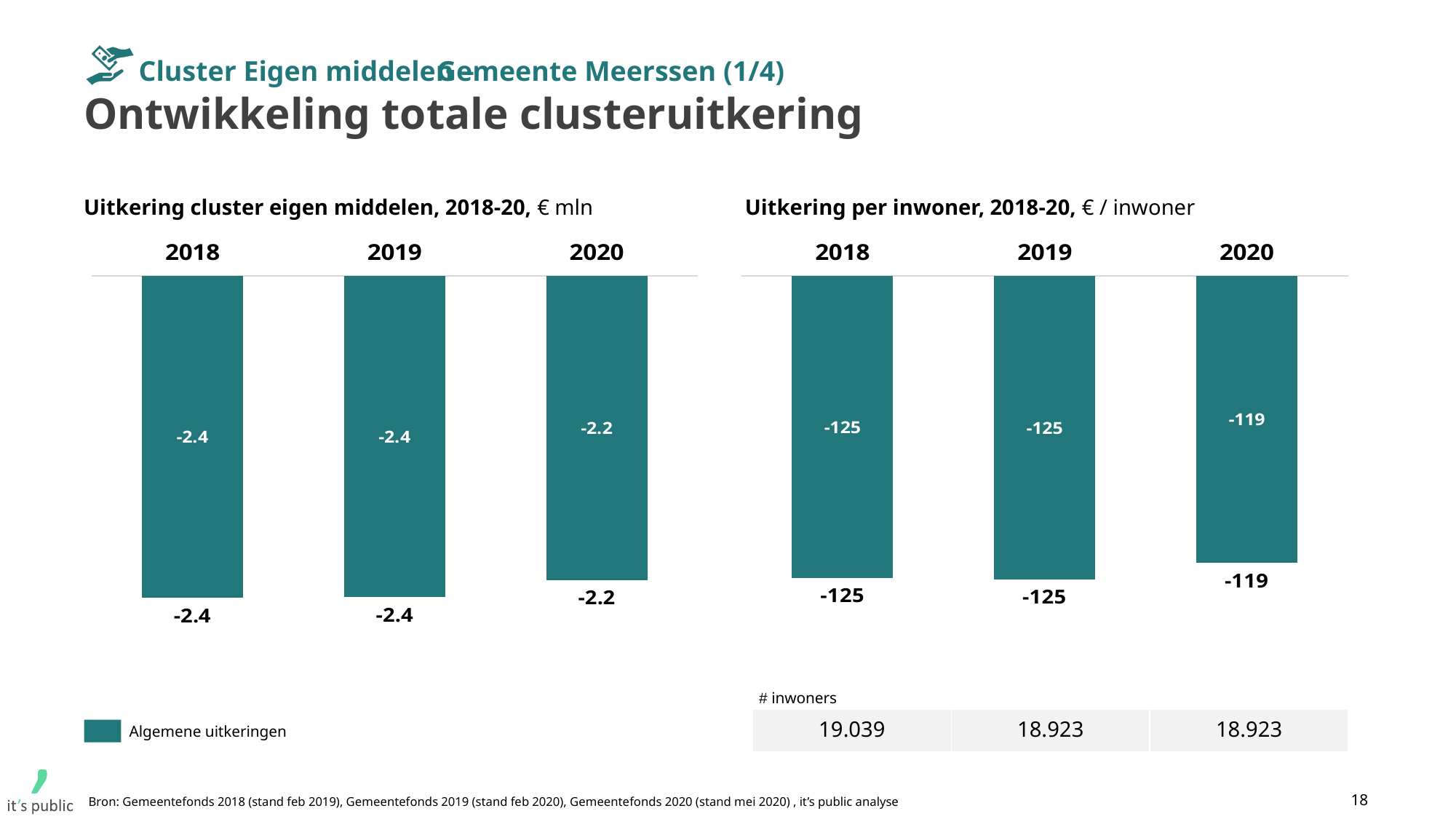
In the chart 'Uitkering cluster eigen middelen, 2018-20', what is the difference between the 2019 value and the 2020 value? 0.2 In the chart 'Uitkering per inwoner, 2018-20', do the values become less negative or more negative from 2018 to 2020? Less negative What kind of chart is 'Uitkering per inwoner, 2018-20'? Bar chart In the chart 'Uitkering per inwoner, 2018-20', which year has the lowest (most negative) value? 2018 and 2019 (both -125) In the '# inwoners' table under the right chart, what is the number of inhabitants for 2018? 19.039 In the chart 'Uitkering cluster eigen middelen, 2018-20', what is the value for 2020? -2.2 In the chart 'Uitkering per inwoner, 2018-20', what is the difference between the 2018 value and the 2020 value? 6 In the chart 'Uitkering cluster eigen middelen, 2018-20', what is the value for 2018? -2.4 What series name does the legend on the slide list? Algemene uitkeringen In the chart 'Uitkering per inwoner, 2018-20', what is the value for 2019? -125 In the chart 'Uitkering per inwoner, 2018-20', what is the value for 2020? -119 In the chart 'Uitkering cluster eigen middelen, 2018-20', how many years are shown? 3